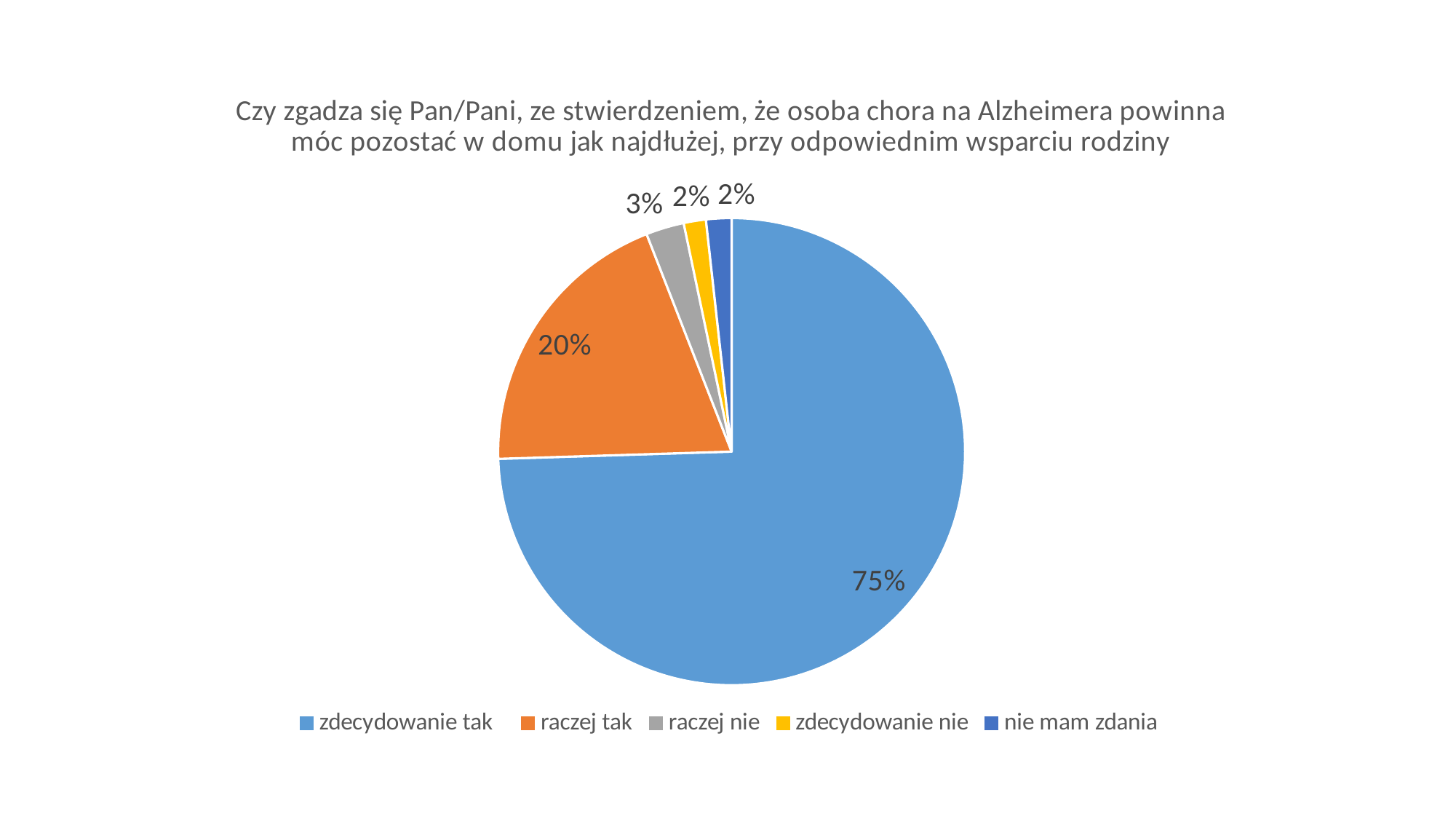
How many entries does the legend list? 5 Which is larger, the share for "raczej tak" or the share for "raczej nie"? raczej tak What is the difference in percentage points between "zdecydowanie tak" and "raczej tak"? 55 What share of respondents answered "raczej tak"? 20% What share of respondents answered "nie mam zdania"? 2% What share of respondents answered "zdecydowanie nie"? 2% How many slices does the pie chart have? 5 What share of respondents answered "raczej nie"? 3% What type of chart is shown on the slide? pie chart What share of respondents answered "zdecydowanie tak"? 75% What colour is the slice for "zdecydowanie nie"? yellow Which answer has the largest slice of the pie? zdecydowanie tak